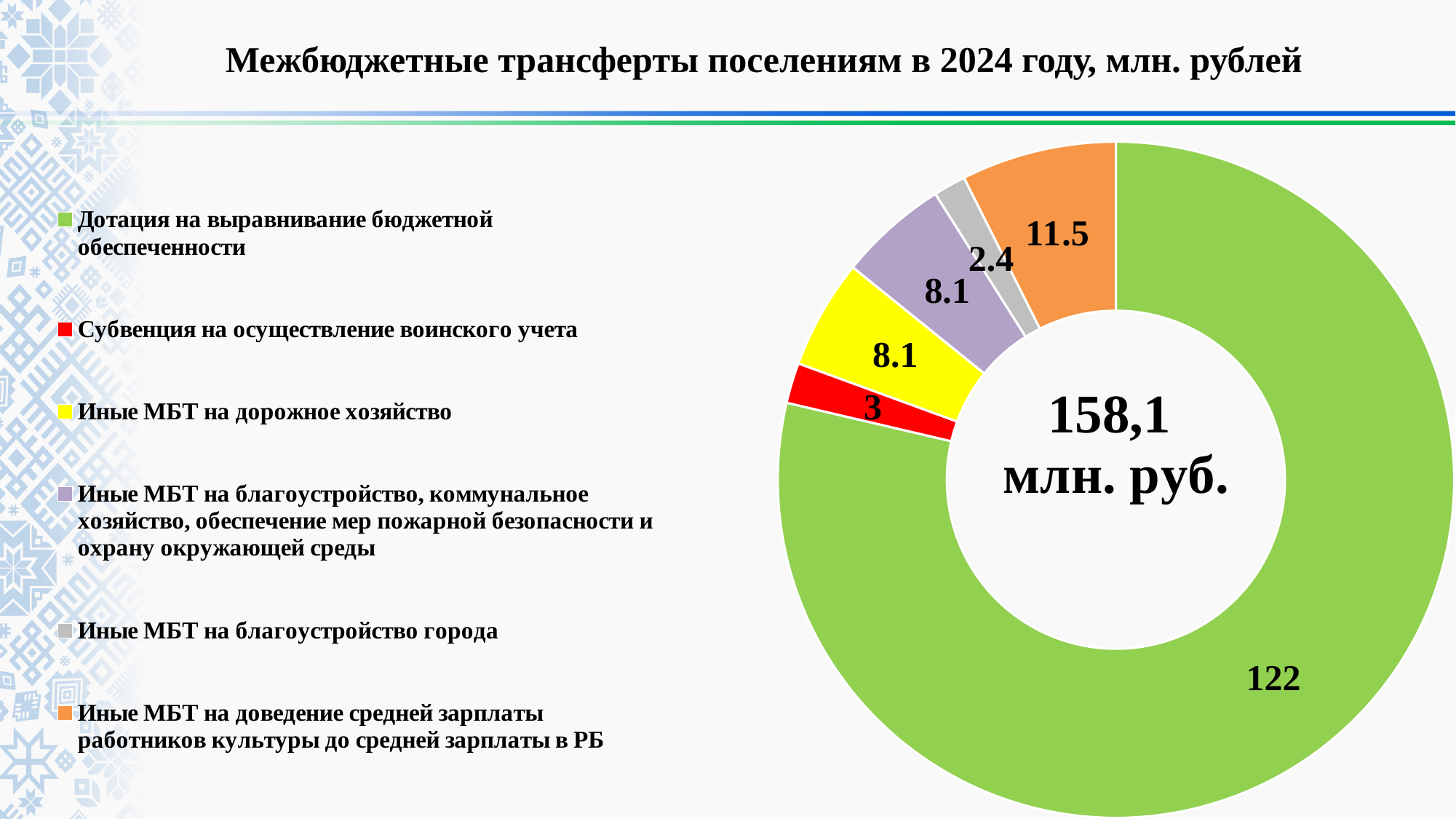
What value is shown for «Иные МБТ на благоустройство города»? 2.4 What total is printed in the centre of the chart? 158,1 млн. руб. Which is larger: the value for «Субвенция на осуществление воинского учета» or the value for «Иные МБТ на дорожное хозяйство»? Иные МБТ на дорожное хозяйство What is the difference between the value for «Дотация на выравнивание бюджетной обеспеченности» and the value for «Иные МБТ на доведение средней зарплаты работников культуры до средней зарплаты в РБ»? 110.5 What value is shown for «Иные МБТ на дорожное хозяйство»? 8.1 What value is shown for «Субвенция на осуществление воинского учета»? 3 What value is shown for «Дотация на выравнивание бюджетной обеспеченности»? 122 Which category has the largest value? Дотация на выравнивание бюджетной обеспеченности What kind of chart is shown on the slide? Doughnut (pie) chart How many categories does the chart show? 6 What value is shown for «Иные МБТ на доведение средней зарплаты работников культуры до средней зарплаты в РБ»? 11.5 Which category has the smallest value? Иные МБТ на благоустройство города